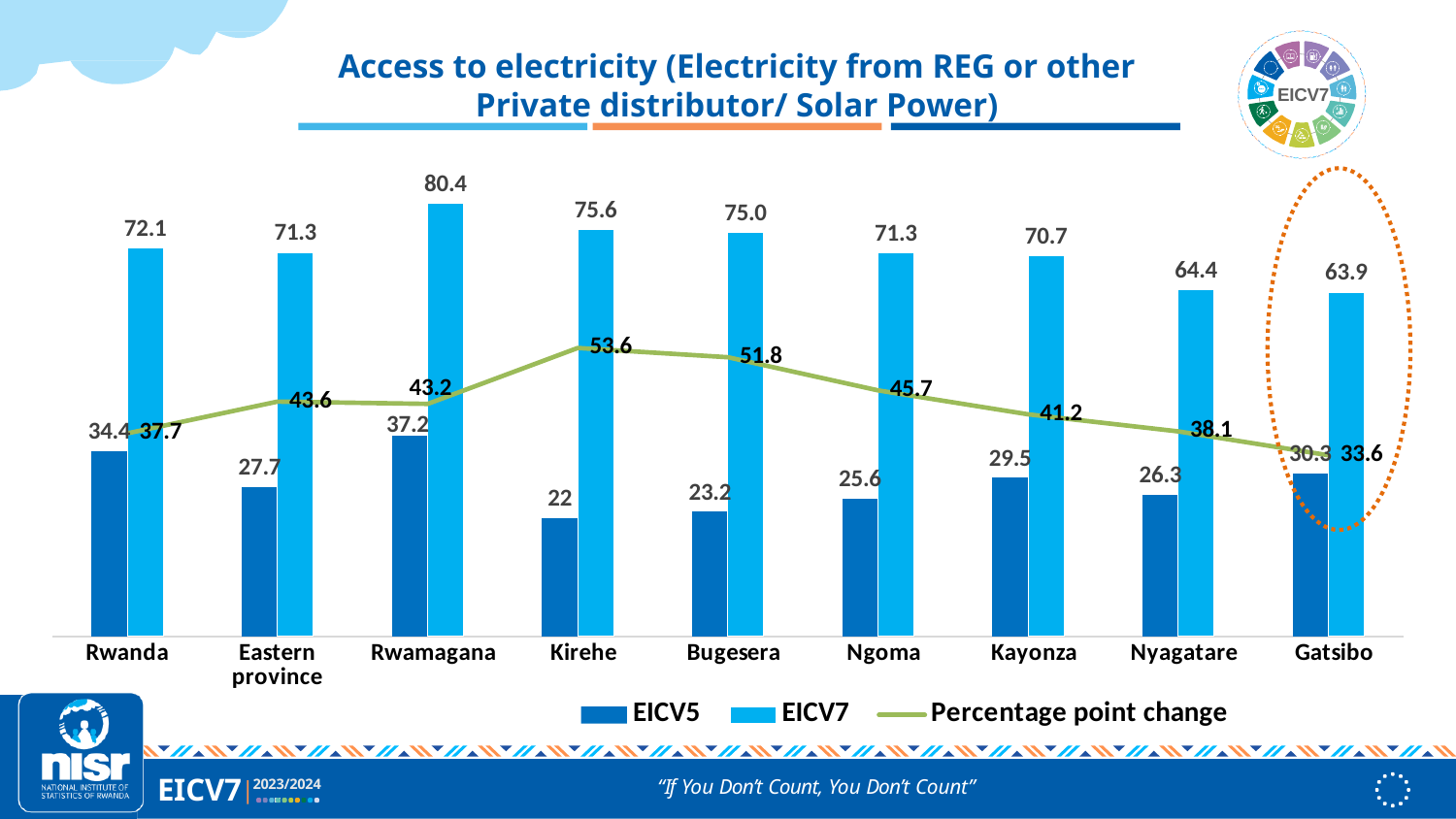
What is the difference between the EICV7 and EICV5 values for Gatsibo? 33.6 How many series does the legend list? 3 Which category has the lowest EICV5 value? Kirehe Which category has the highest EICV7 value? Rwamagana What is the percentage point change for Bugesera? 51.8 What is the EICV7 value for Rwamagana? 80.4 Which category has the highest percentage point change? Kirehe Which series is shown as a green line? Percentage point change What is the EICV5 value for Kirehe? 22 How many categories are shown on the x axis? 9 Which is larger, the EICV7 value for Nyagatare or the EICV7 value for Kayonza? Kayonza What kind of chart is this? Bar chart with a line